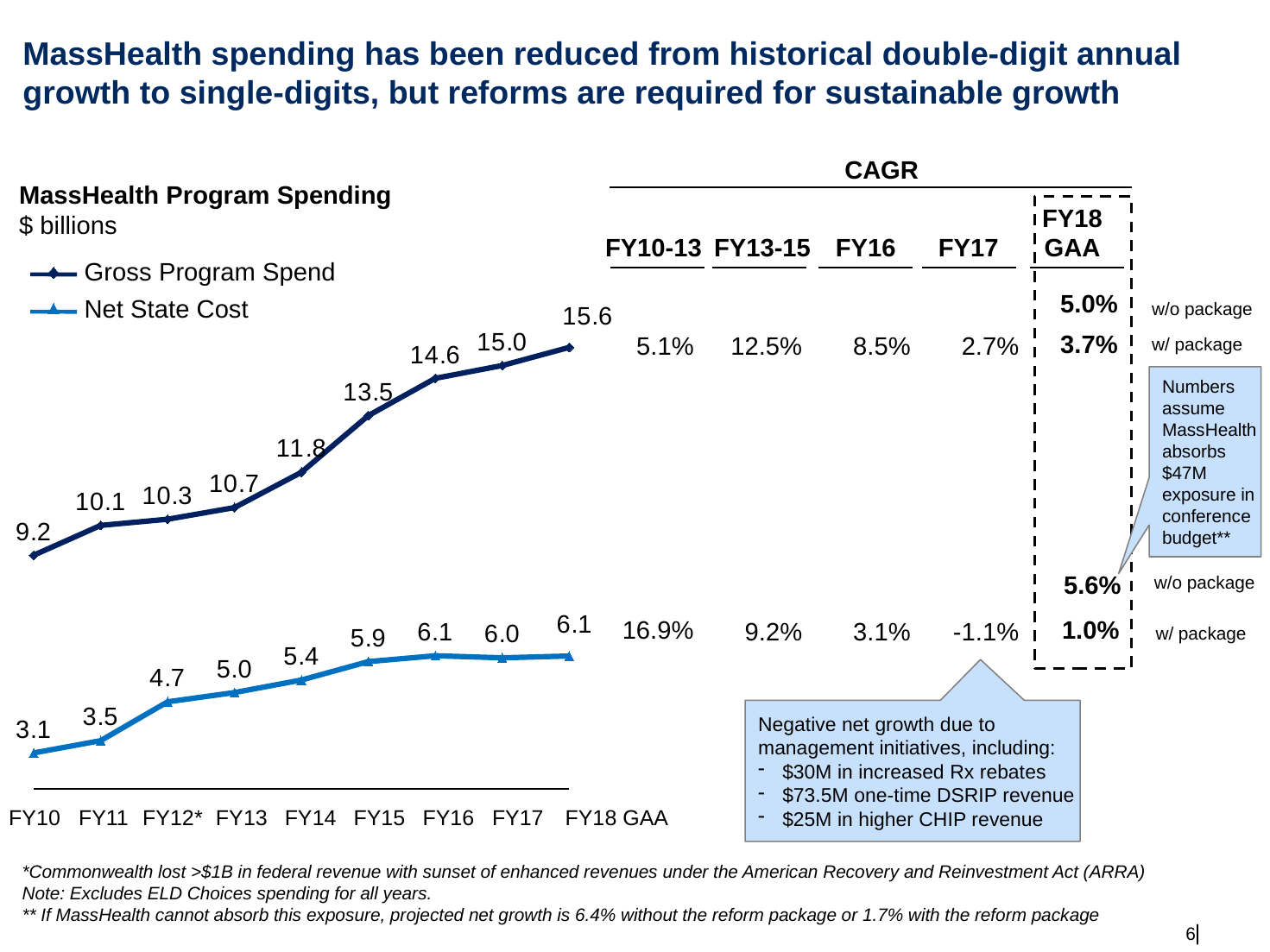
How many fiscal years are plotted along the x axis of the chart? 9 What is the Net State Cost value for FY12*? 4.7 By how much did Gross Program Spend increase from FY10 to FY18 GAA? 6.4 What unit is stated under the chart title 'MassHealth Program Spending'? $ billions What type of chart is shown on the slide? Line chart In which fiscal year is Gross Program Spend lowest? FY10 How many series does the chart legend list? 2 Which is larger, Net State Cost in FY16 or Net State Cost in FY17? FY16 What is the difference between Gross Program Spend and Net State Cost in FY16? 8.5 What is the Gross Program Spend value for FY14? 11.8 Does Gross Program Spend generally rise or fall from FY10 to FY18 GAA? Rise What is the Gross Program Spend value for FY18 GAA? 15.6